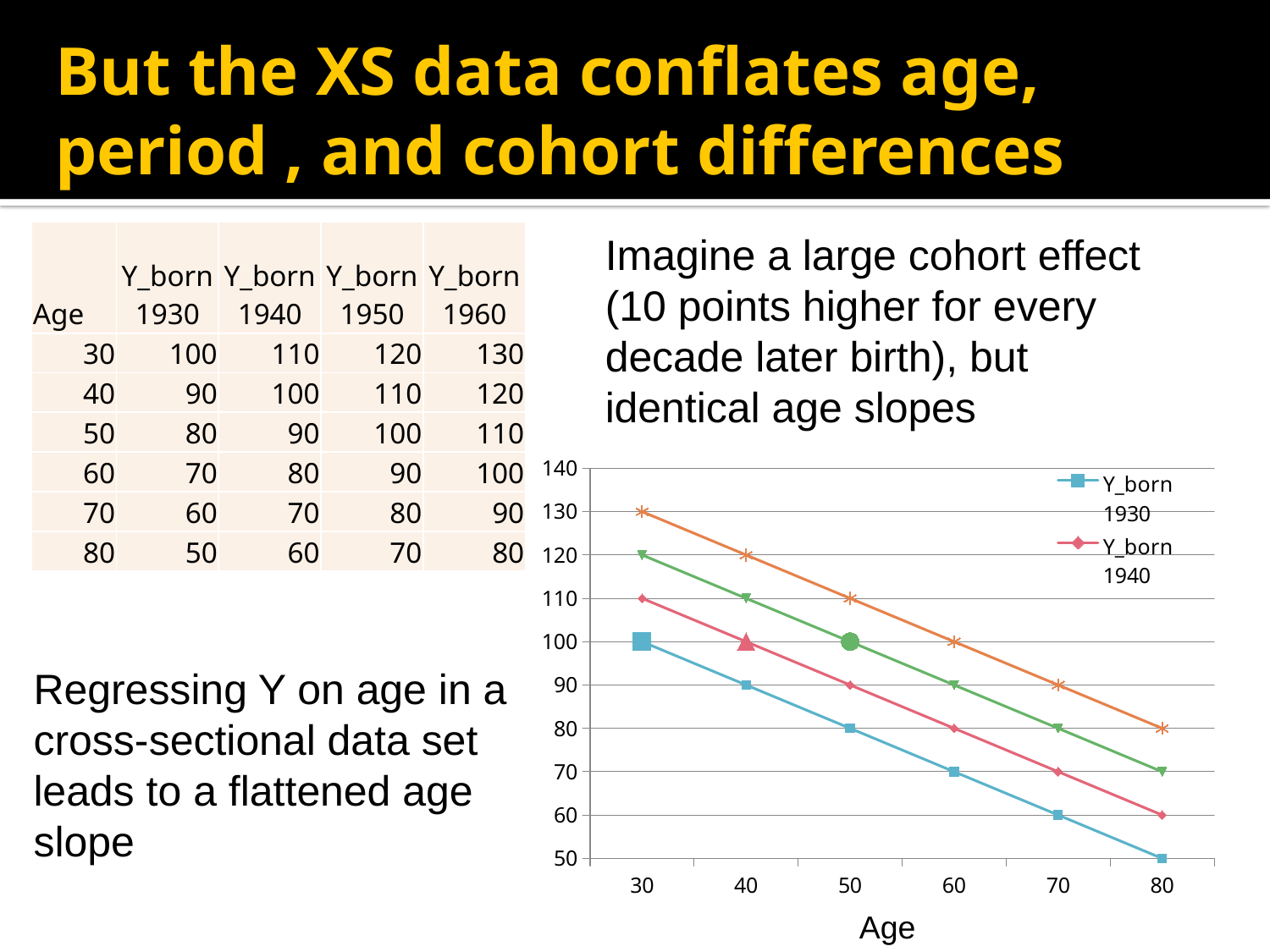
What is the value for Y_born 1930 at age 30? 100 What is the value for Y_born 1940 at age 50? 90 At which age is the value for Y_born 1940 highest? 30 What is the difference between the Y_born 1940 and Y_born 1930 values at age 30? 10 At which age is the value for Y_born 1930 lowest? 80 Is the value for Y_born 1930 at age 40 greater or less than 100? less What kind of chart is shown on the slide? line chart What is the value for Y_born 1930 at age 80? 50 At age 60, which series has the larger value, Y_born 1930 or Y_born 1940? Y_born 1940 What is the label of the x axis of the chart? Age How many age values are plotted along the x axis of the chart? 6 Do the values for Y_born 1930 rise or fall as age increases along the x axis? fall